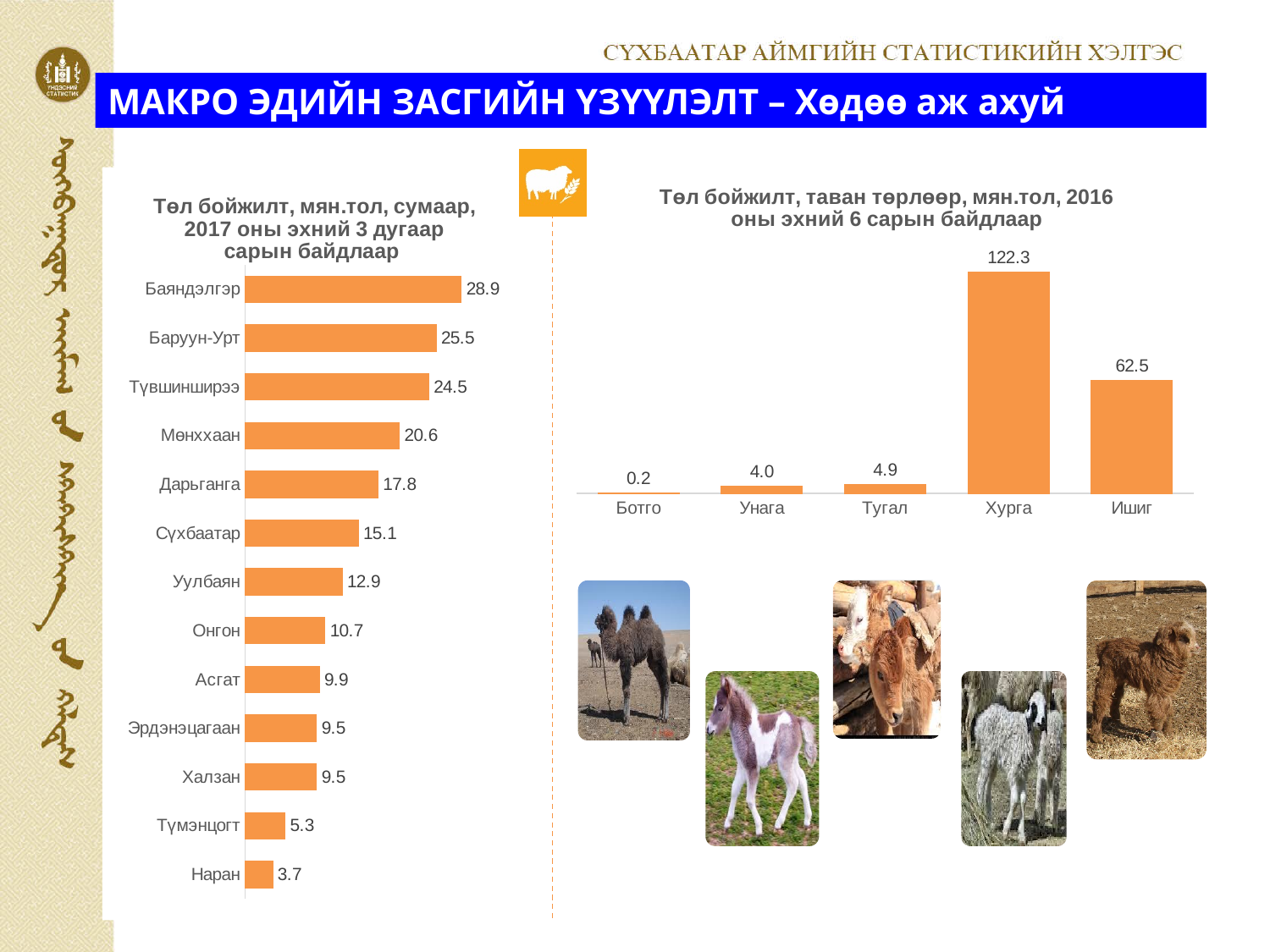
In the left chart (Төл бойжилт, мян.тол, сумаар, 2017), what is the value for Баяндэлгэр? 28.9 In the right chart (Төл бойжилт, таван төрлөөр, 2016), what is the value for Ботго? 0.2 In the left chart (Төл бойжилт, мян.тол, сумаар, 2017), how many sums are shown? 13 In the right chart (Төл бойжилт, таван төрлөөр, 2016), what is the difference between Хурга and Ишиг? 59.8 In the right chart (Төл бойжилт, таван төрлөөр, 2016), which category has the highest value? Хурга What type of chart is the left chart (Төл бойжилт, мян.тол, сумаар, 2017)? Bar chart In the left chart (Төл бойжилт, мян.тол, сумаар, 2017), which sum has the lowest value? Наран In the left chart (Төл бойжилт, мян.тол, сумаар, 2017), what is the value for Түмэнцогт? 5.3 In the right chart (Төл бойжилт, таван төрлөөр, 2016), what is the value for Ишиг? 62.5 In the left chart (Төл бойжилт, мян.тол, сумаар, 2017), what is the difference between Баруун-Урт and Түвшинширээ? 1.0 In the left chart (Төл бойжилт, мян.тол, сумаар, 2017), which is larger, Дарьганга or Сүхбаатар? Дарьганга In the right chart (Төл бойжилт, таван төрлөөр, 2016), how many categories are shown? 5